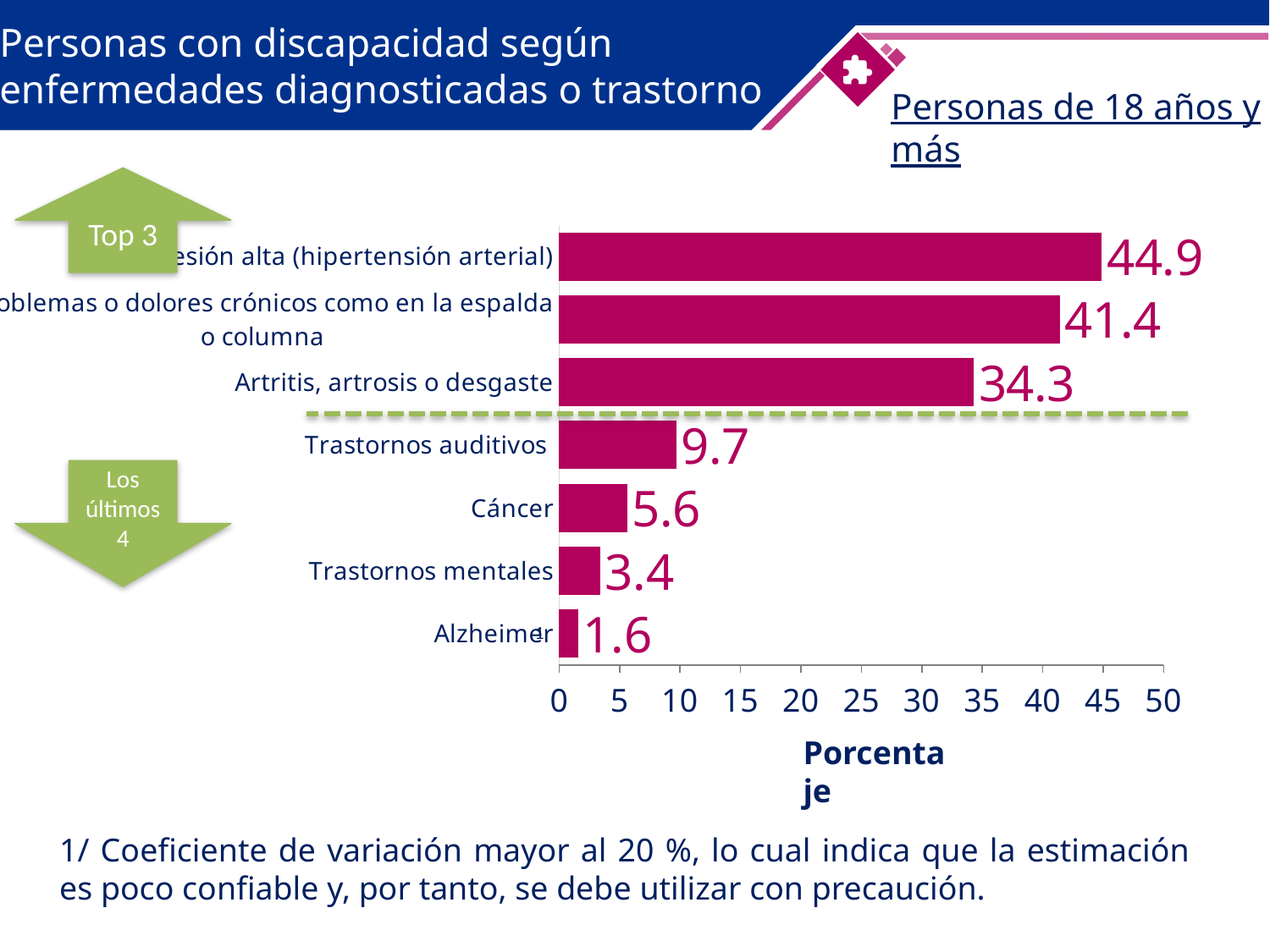
What is the value for Cáncer? 5.6 Which is larger, the value for Trastornos mentales or the value for Cáncer? Cáncer Which category has the highest value? Presión alta (hipertensión arterial) What kind of chart is shown on the slide? Bar chart What is the value for Artritis, artrosis o desgaste? 34.3 What is the difference between the values for Trastornos auditivos and Cáncer? 4.1 How many categories are shown in the chart? 7 What is the difference between the values for hipertensión arterial and Artritis, artrosis o desgaste? 10.6 What is the value for Trastornos auditivos? 9.7 What is the value for Trastornos mentales? 3.4 What is the value for Alzheimer? 1.6 Which category has the lowest value? Alzheimer